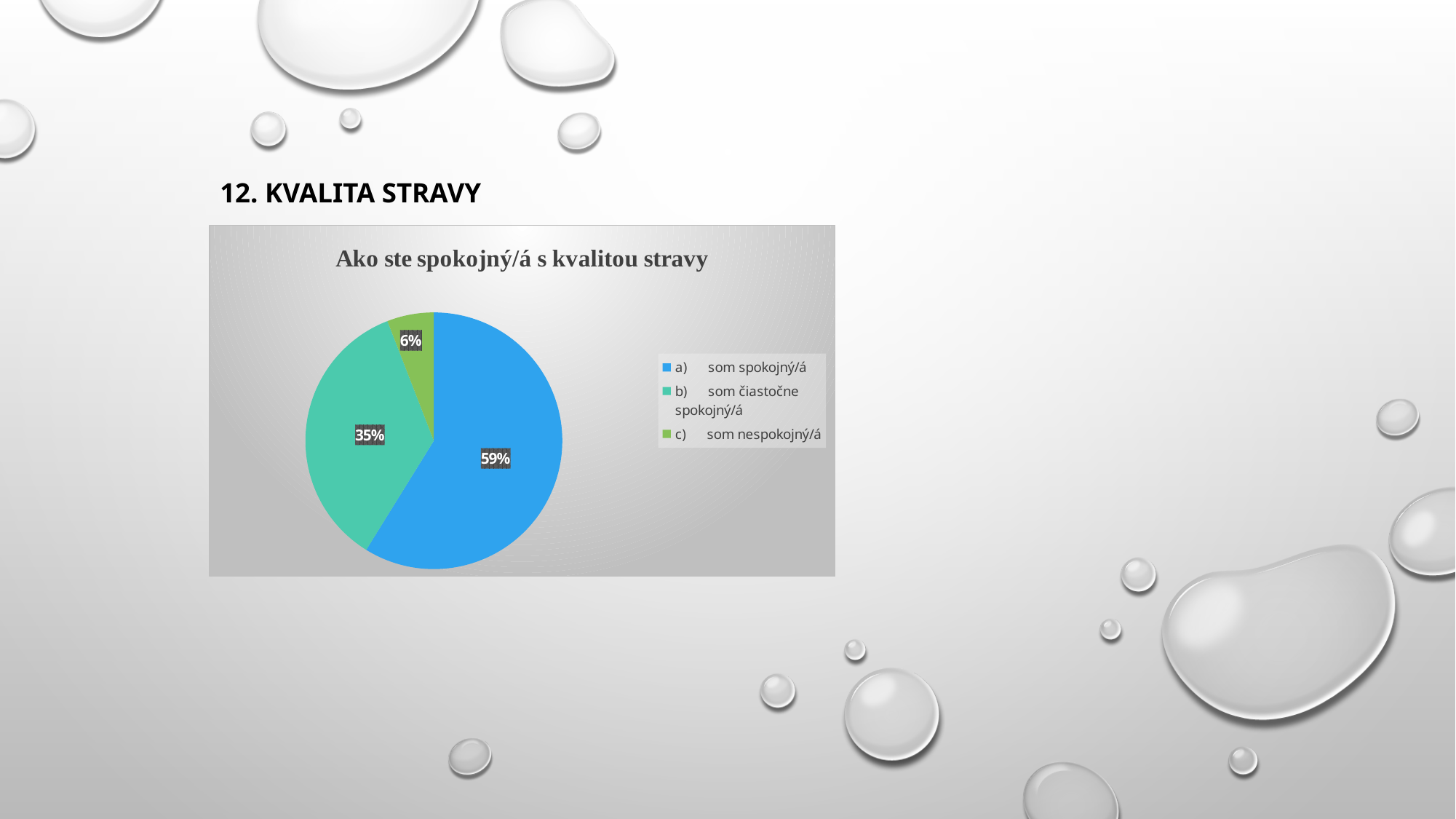
What share of the pie is labelled "b) som čiastočne spokojný/á"? 35% What is the difference in percentage points between the "a) som spokojný/á" slice and the "b) som čiastočne spokojný/á" slice? 24 What colour is the slice for "a) som spokojný/á"? blue What is the title of the chart? Ako ste spokojný/á s kvalitou stravy How many slices does the pie chart have? 3 What share of the pie is labelled "a) som spokojný/á"? 59% What kind of chart is shown on the slide? pie chart Which category has the largest slice of the pie? a) som spokojný/á Which category has the smallest slice of the pie? c) som nespokojný/á Which slice is larger: "b) som čiastočne spokojný/á" or "c) som nespokojný/á"? b) som čiastočne spokojný/á What share of the pie is labelled "c) som nespokojný/á"? 6% How many entries does the legend list? 3